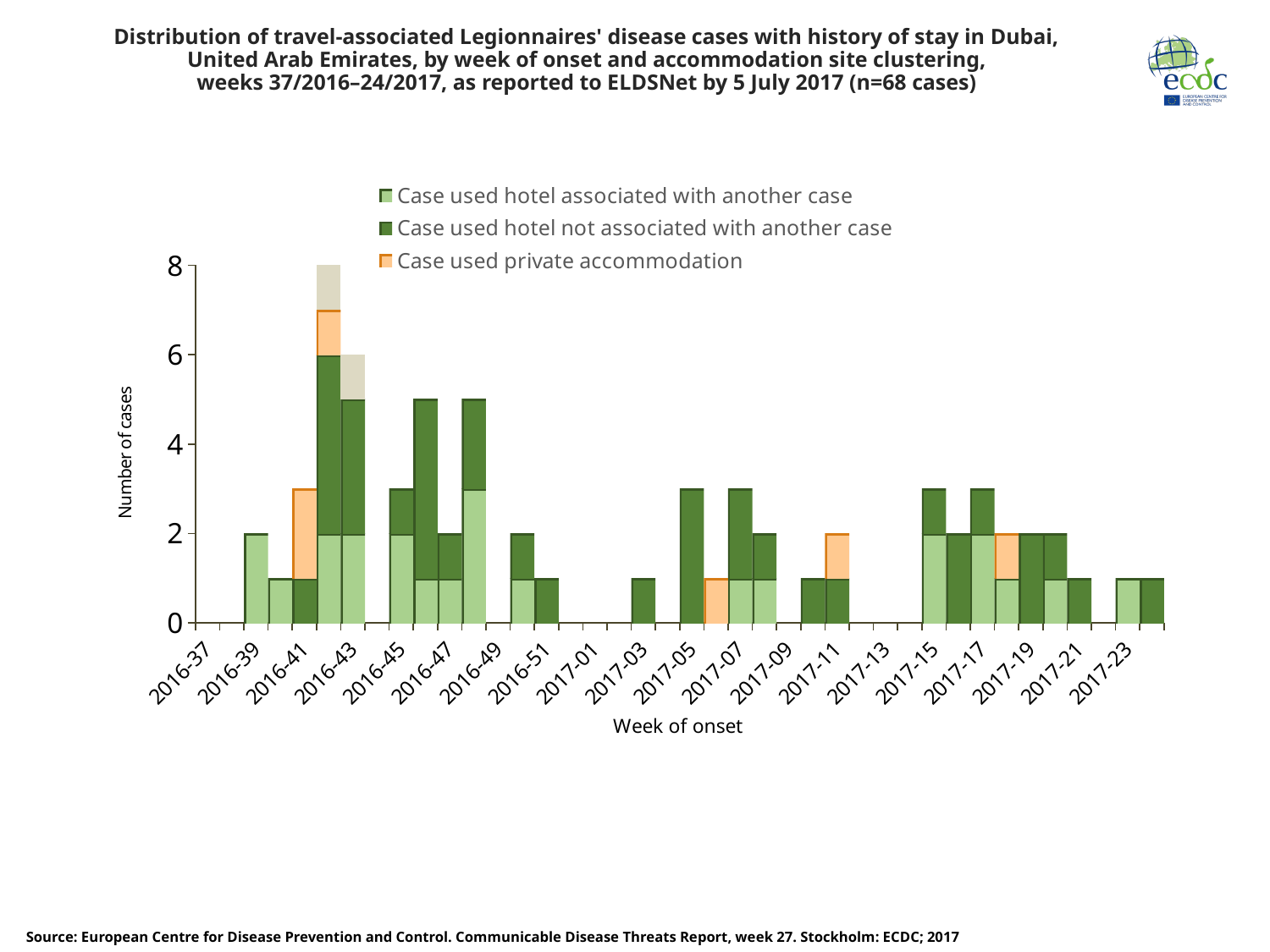
What is the total number of cases for week 2016-43? 6 What is the label on the vertical axis? Number of cases Which week has more cases in total, 2016-48 or 2017-07? 2016-48 Which week of onset has the highest total number of cases? 2016-42 Which colour represents cases that used private accommodation? Orange What is the total number of cases for week 2016-42? 8 How many series does the legend list? 3 Is the total number of cases for week 2017-05 greater or less than 4? less What kind of chart is shown on the slide? Stacked bar chart Is the total number of cases for week 2016-46 greater or less than 4? greater Which week has more cases in total, 2016-42 or 2016-46? 2016-42 What is the total number of cases for week 2016-39? 2